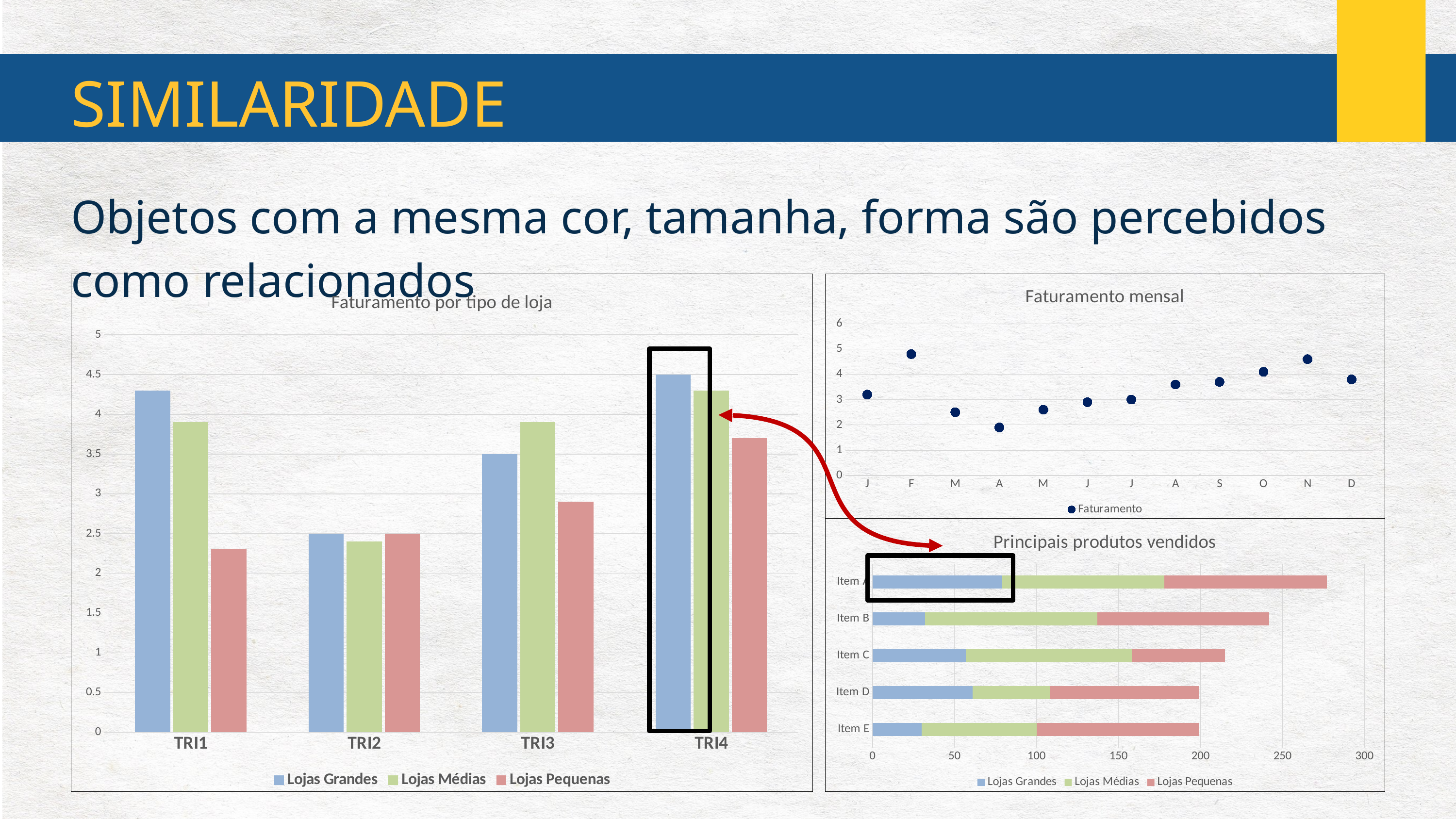
How many data points are plotted in 'Faturamento mensal'? 12 What kind of chart is 'Faturamento por tipo de loja'? bar chart In 'Faturamento mensal', is the value for F greater or less than 4? greater How many quarters are shown on the x axis of 'Faturamento por tipo de loja'? 4 In 'Faturamento mensal', which month has the lowest value? A How many items are listed on the y axis of 'Principais produtos vendidos'? 5 In 'Faturamento por tipo de loja', which quarter has the highest value for Lojas Grandes? TRI4 How many series does the legend of 'Faturamento por tipo de loja' list? 3 In 'Faturamento por tipo de loja', which is larger in TRI3: Lojas Grandes or Lojas Médias? Lojas Médias In 'Faturamento por tipo de loja', is the value for Lojas Grandes in TRI1 greater or less than 4? greater In 'Faturamento por tipo de loja', which quarter has the lowest value for Lojas Pequenas? TRI1 In 'Principais produtos vendidos', which item has the longest total bar? Item A